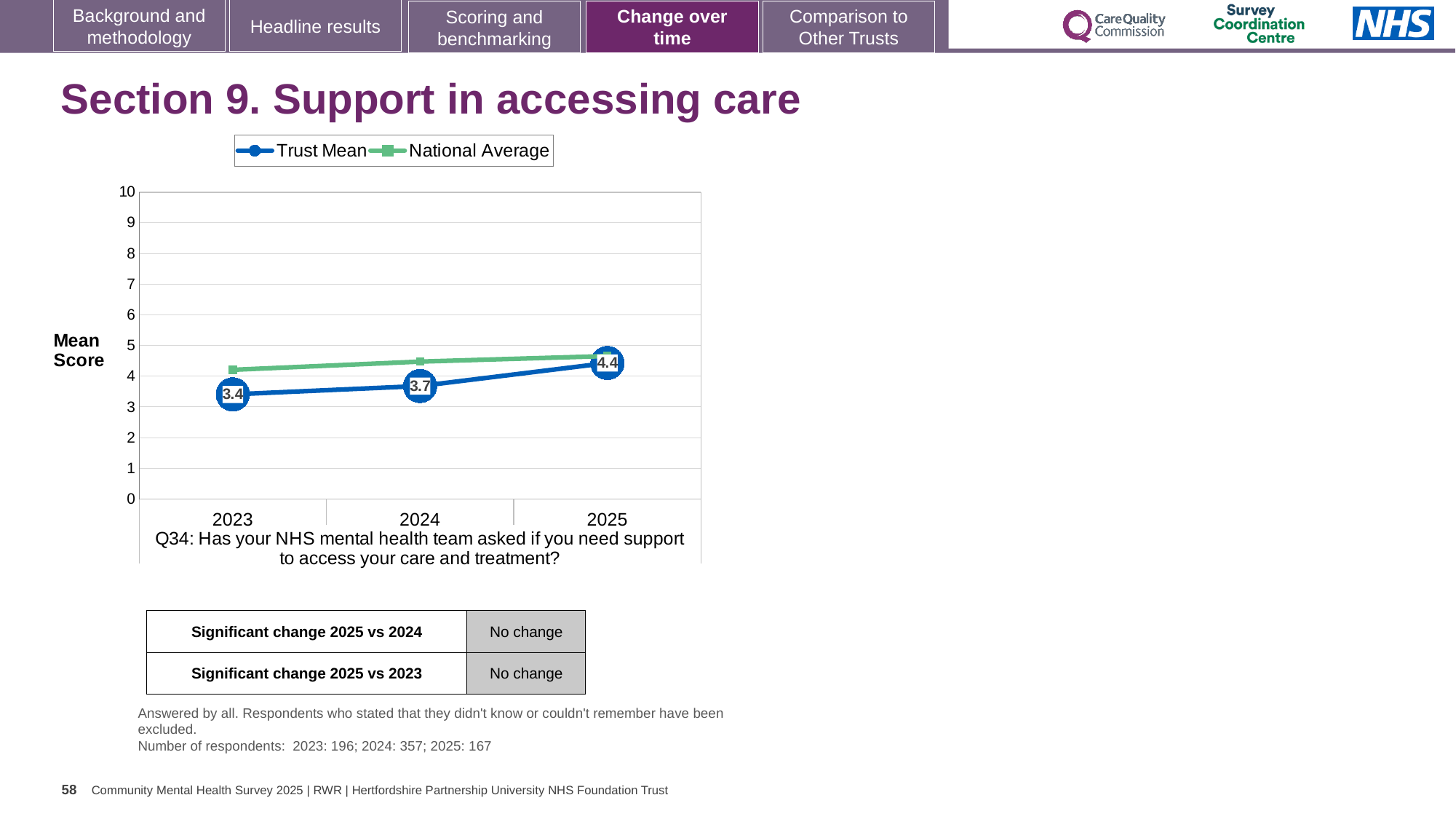
What is the Trust Mean score for 2023? 3.4 Does the Trust Mean score rise or fall from 2023 to 2025? rise What is the Trust Mean score for 2025? 4.4 In which year is the Trust Mean score highest? 2025 In which year is the Trust Mean score lowest? 2023 How many years are shown on the x axis? 3 In 2023, which is larger: the Trust Mean or the National Average? National Average What is the Trust Mean score for 2024? 3.7 What kind of chart is shown? line chart What is the difference between the Trust Mean score in 2025 and in 2023? 1.0 How many series does the legend list? 2 Is the National Average value for 2024 greater or less than 5? less